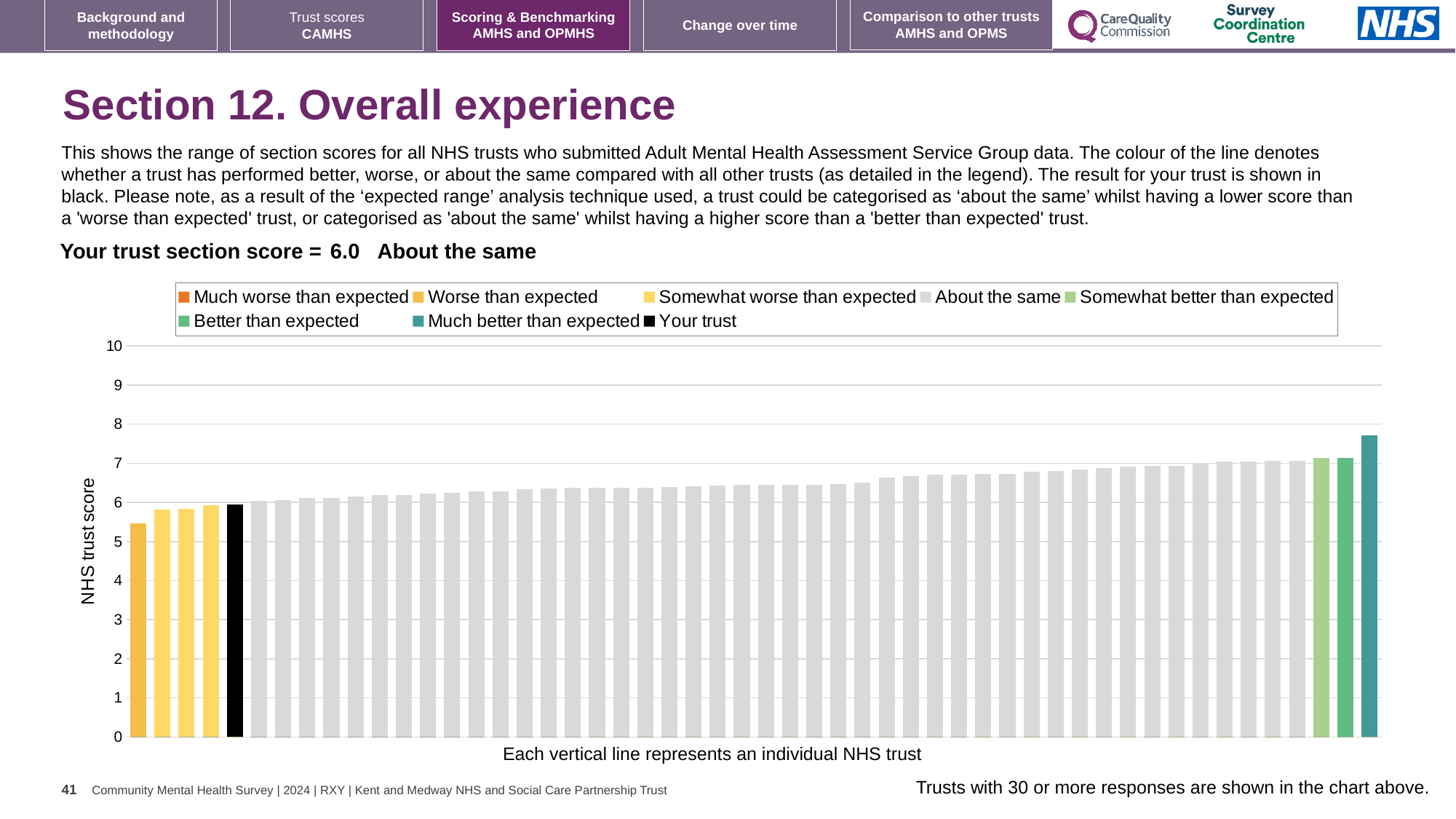
What kind of chart is shown on the slide? bar chart How many bars are coloured as 'Somewhat better than expected'? 1 Is the value of the tallest bar (the 'Much better than expected' bar at the far right) greater or less than 7? greater Is the value of the black 'Your trust' bar greater or less than 5? greater Which category is your trust placed in, according to the text above the chart? About the same Is the value of the leftmost bar greater or less than 6? less What is the section score for your trust, as printed on the slide? 6.0 What is the label on the vertical axis? NHS trust score Is the 'Your trust' bar higher or lower than the tallest bar on the right? lower Do the bar values rise or fall from left to right along the x axis? rise Which legend category does the tallest bar belong to? Much better than expected How many entries does the chart legend list? 8